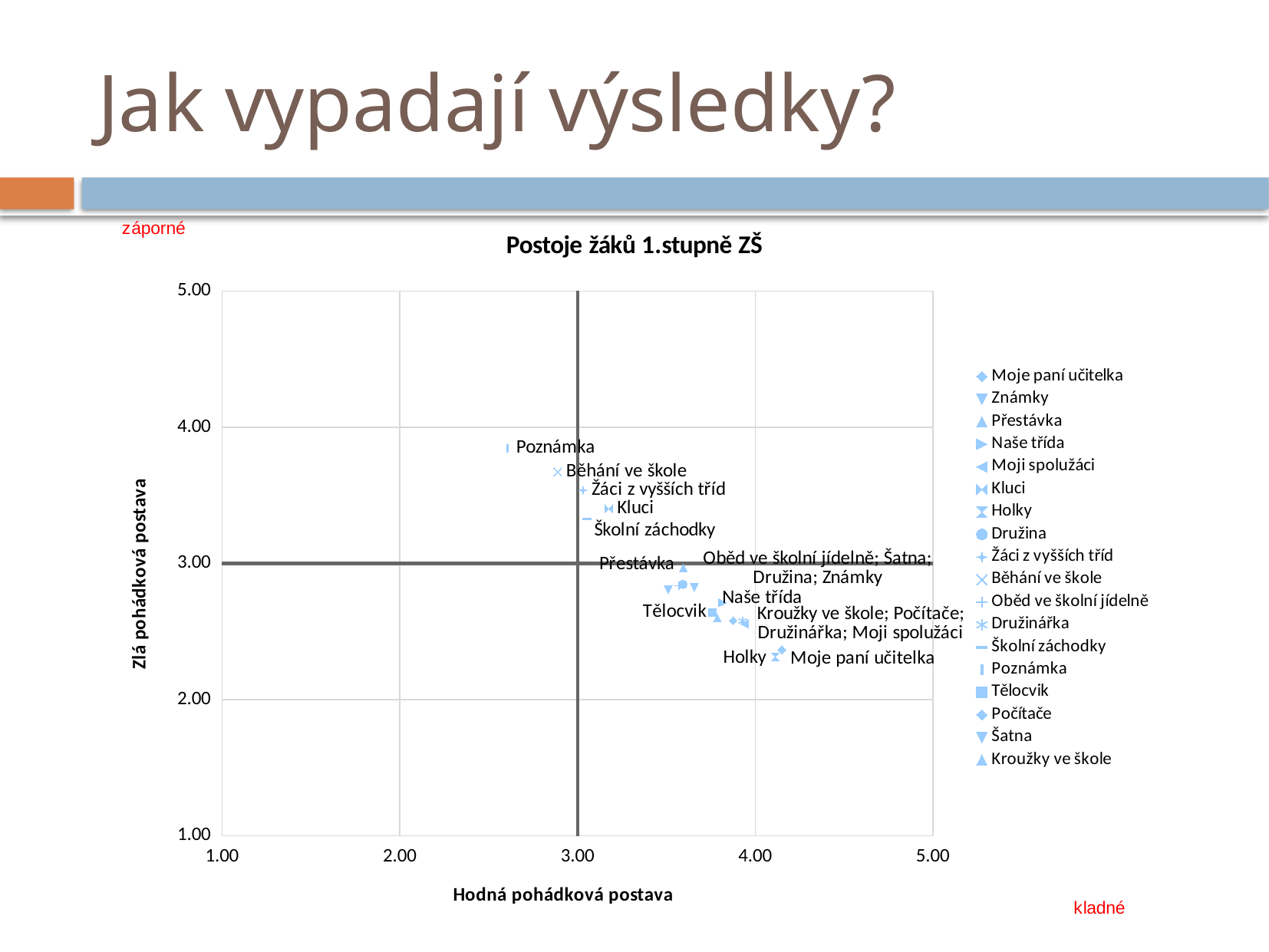
Which has the larger horizontal-axis value, Běhání ve škole or Kluci? Kluci Which has the higher vertical-axis value, Poznámka or Holky? Poznámka Which series has the lowest value on the horizontal axis (Hodná pohádková postava)? Poznámka What is the title of the chart? Postoje žáků 1.stupně ZŠ What is the title of the horizontal axis? Hodná pohádková postava Is the horizontal-axis value for Moje paní učitelka greater or less than 4.00? greater Is the horizontal-axis value for Běhání ve škole greater or less than 3.00? less What kind of chart is shown on the slide? scatter chart Is the vertical-axis value for Poznámka greater or less than 3.00? greater How many series does the chart legend list? 18 Which series has the highest value on the vertical axis (Zlá pohádková postava)? Poznámka